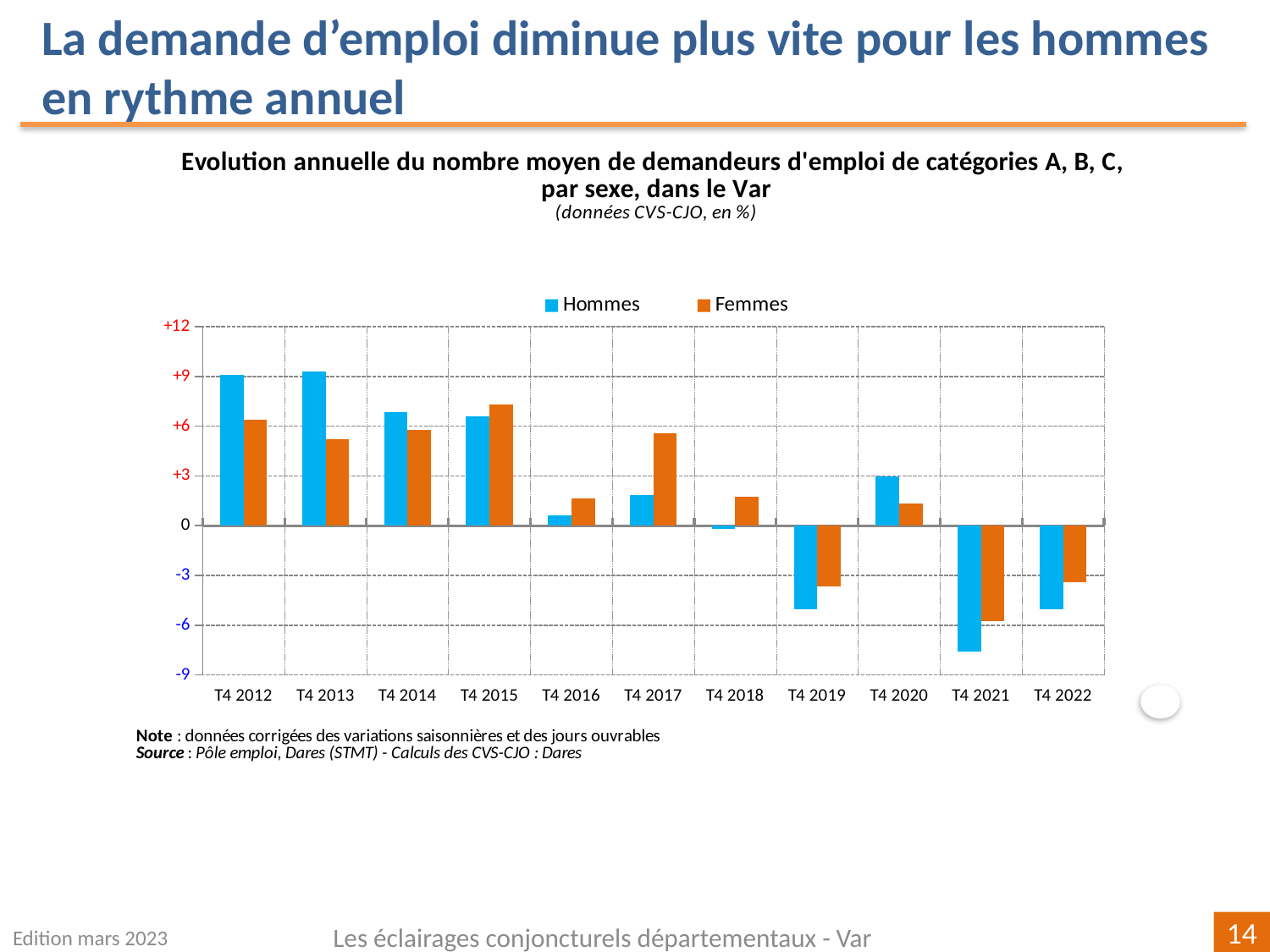
In T4 2012, which series has the larger value, Hommes or Femmes? Hommes Is the value for Hommes in T4 2019 greater or less than -3? less How many quarters (categories) are shown on the x axis? 11 In T4 2017, which series has the larger value, Hommes or Femmes? Femmes Which quarter has the lowest value for Femmes? T4 2021 Is the value for Hommes in T4 2021 greater or less than -6? less Do the values for Hommes rise or fall from T4 2013 to T4 2016? fall Is the value for Femmes in T4 2017 greater or less than 3? greater Which quarter has the highest value for Femmes? T4 2015 How many series does the legend list? 2 What kind of chart is shown on the slide? bar chart Which quarter has the lowest value for Hommes? T4 2021